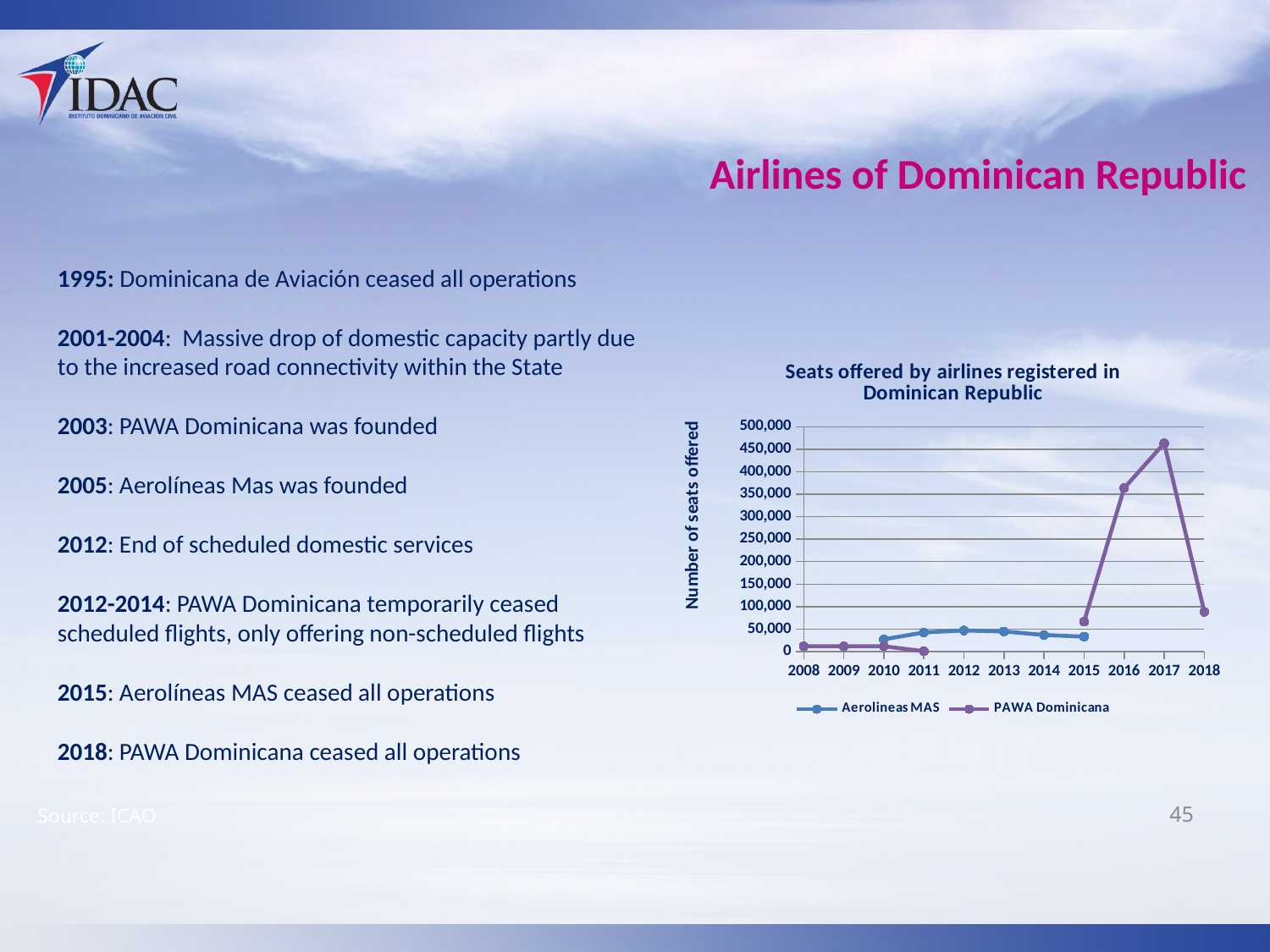
Which is larger for PAWA Dominicana: the value in 2016 or the value in 2017? 2017 In 2015, which series has the larger value: Aerolineas MAS or PAWA Dominicana? PAWA Dominicana What is the label on the vertical axis of the chart? Number of seats offered Is the value for PAWA Dominicana in 2016 greater or less than 300,000? greater What is the title of the chart? Seats offered by airlines registered in Dominican Republic In which year does the PAWA Dominicana series reach its highest value? 2017 Is the value for PAWA Dominicana in 2017 greater or less than 400,000? greater How many years are shown on the x axis of the chart? 11 What kind of chart is shown on the slide? line chart Is the value for PAWA Dominicana in 2018 greater or less than 150,000? less How many series does the chart legend list? 2